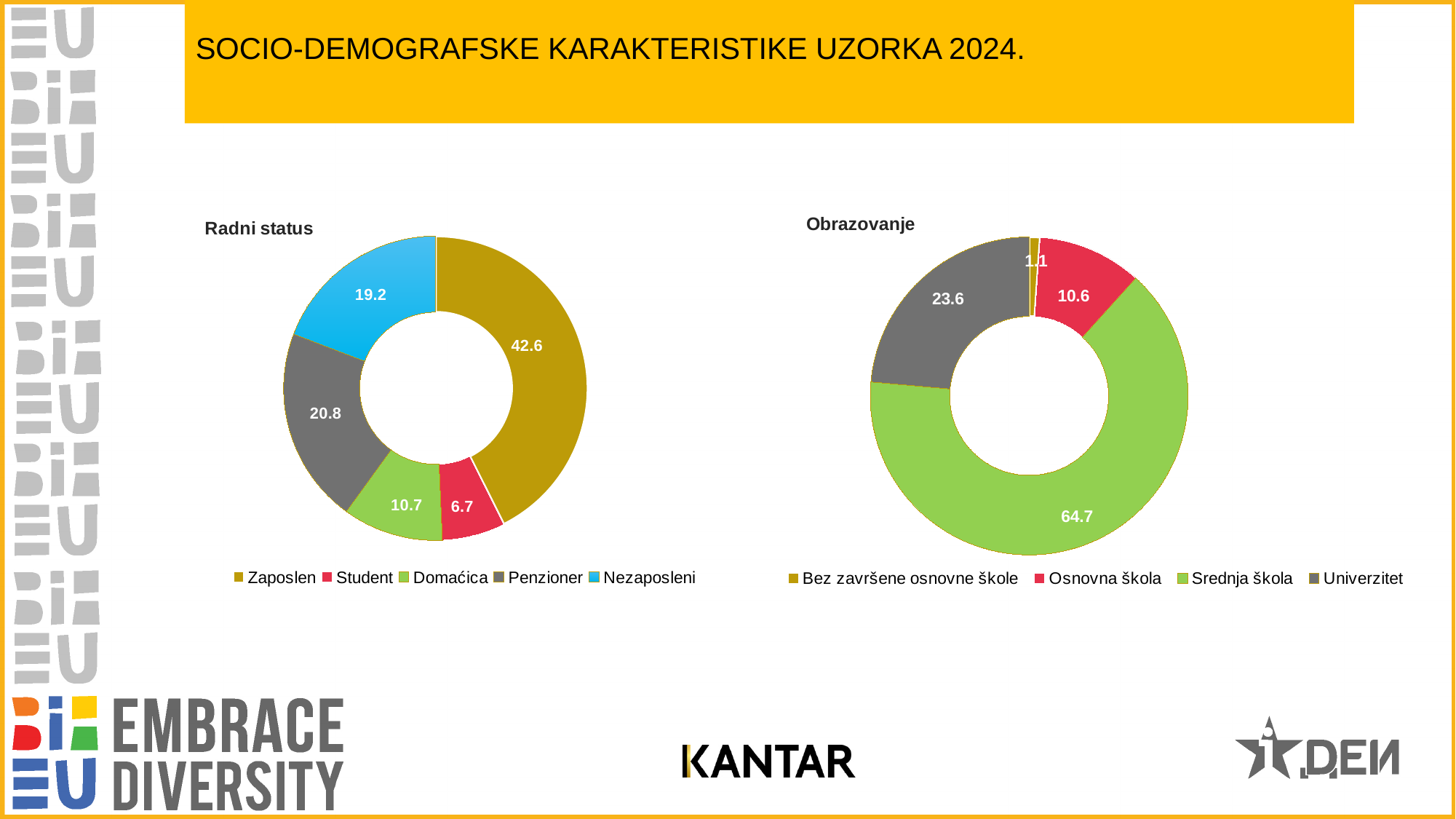
In the 'Obrazovanje' chart, what is the value for Bez završene osnovne škole? 1.1 In the 'Obrazovanje' chart, which category has the largest share? Srednja škola In the 'Radni status' chart, how many categories are shown? 5 In the 'Radni status' chart, what is the difference between Penzioner and Domaćica? 10.1 In the 'Obrazovanje' chart, what is the difference between Srednja škola and Univerzitet? 41.1 In the 'Radni status' chart, what is the value for Nezaposleni? 19.2 In the 'Radni status' chart, which category has the smallest share? Student In the 'Radni status' chart, what is the value for Zaposlen? 42.6 In the 'Radni status' chart, which category has the largest share? Zaposlen In the 'Obrazovanje' chart, what is the value for Univerzitet? 23.6 In the 'Obrazovanje' chart, which is larger: Osnovna škola or Univerzitet? Univerzitet What type of chart is the 'Obrazovanje' chart? Doughnut (pie) chart